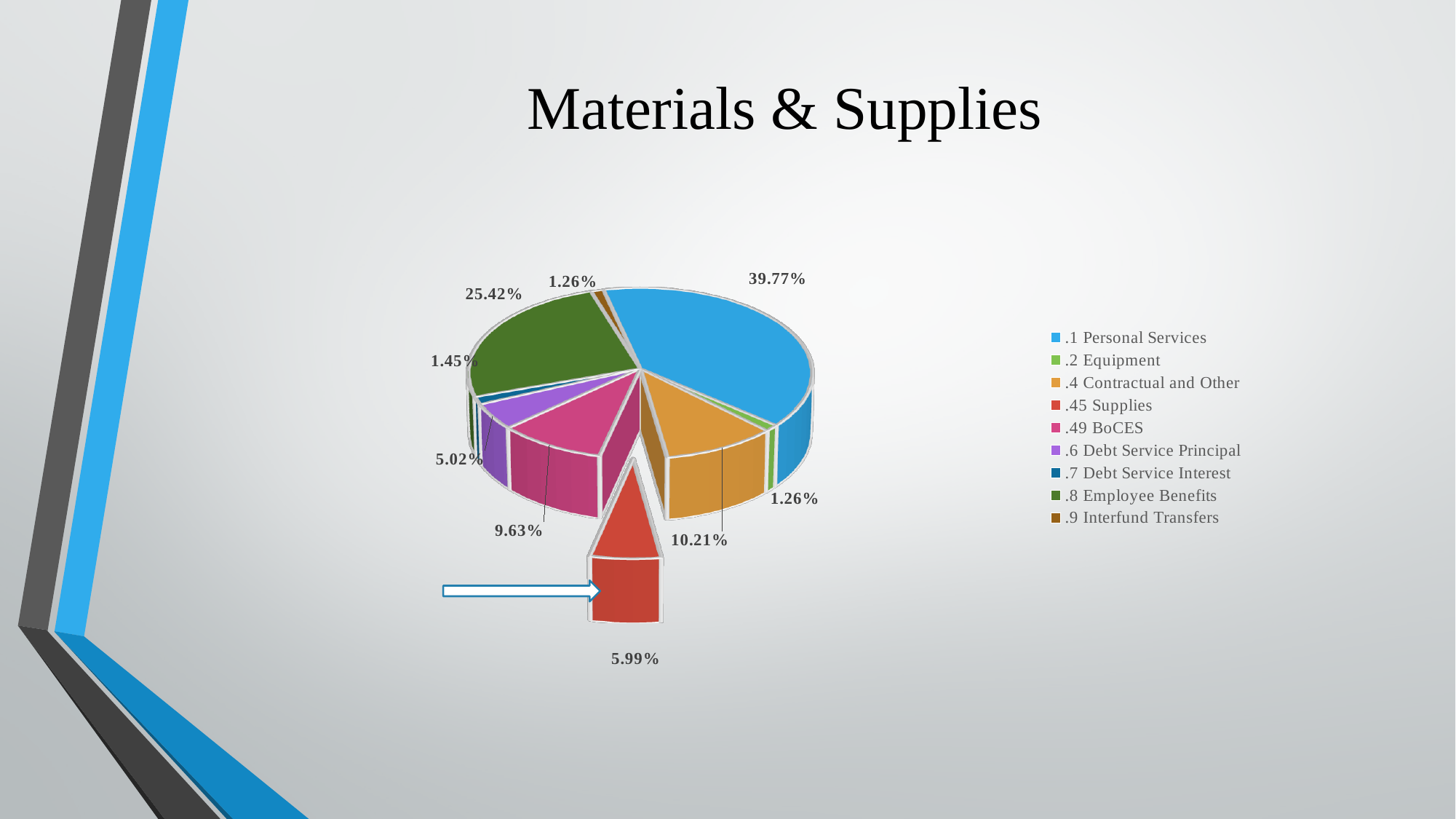
What type of chart is shown on the slide? pie chart What is the difference between the shares of .1 Personal Services and .8 Employee Benefits? 14.35% What share of the pie is .49 BoCES? 9.63% Which category is shown as the exploded slice pulled out of the pie? .45 Supplies Which has a larger share, .49 BoCES or .6 Debt Service Principal? .49 BoCES What is the title of the slide? Materials & Supplies How many categories does the legend list? 9 What share of the pie is .8 Employee Benefits? 25.42% What share of the pie is .45 Supplies, the exploded slice? 5.99% Which category has the largest share of the pie? .1 Personal Services What share of the pie is .1 Personal Services? 39.77% What share of the pie is .4 Contractual and Other? 10.21%